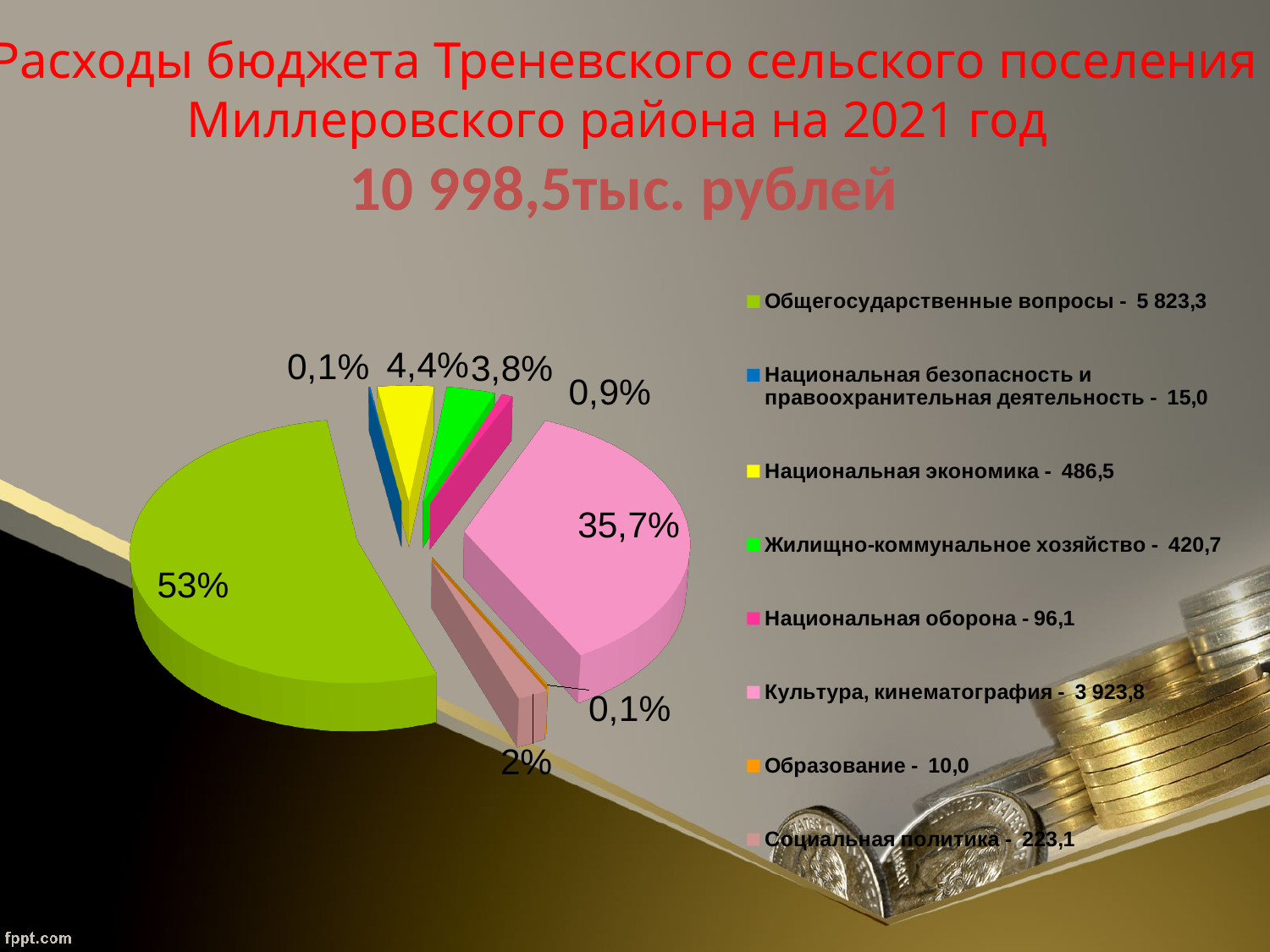
Which category has the largest slice of the pie? Общегосударственные вопросы What is the difference between the legend values for Общегосударственные вопросы and Культура, кинематография? 1 899,5 What share of the pie does Общегосударственные вопросы take? 53% What share of the pie does Культура, кинематография take? 35,7% What value is given in the legend for Национальная оборона? 96,1 What kind of chart is shown on the slide? pie chart What share of the pie does Социальная политика take? 2% Which is larger, the value for Национальная экономика or the value for Жилищно-коммунальное хозяйство? Национальная экономика How many categories does the pie chart have? 8 What value is given in the legend for Образование? 10,0